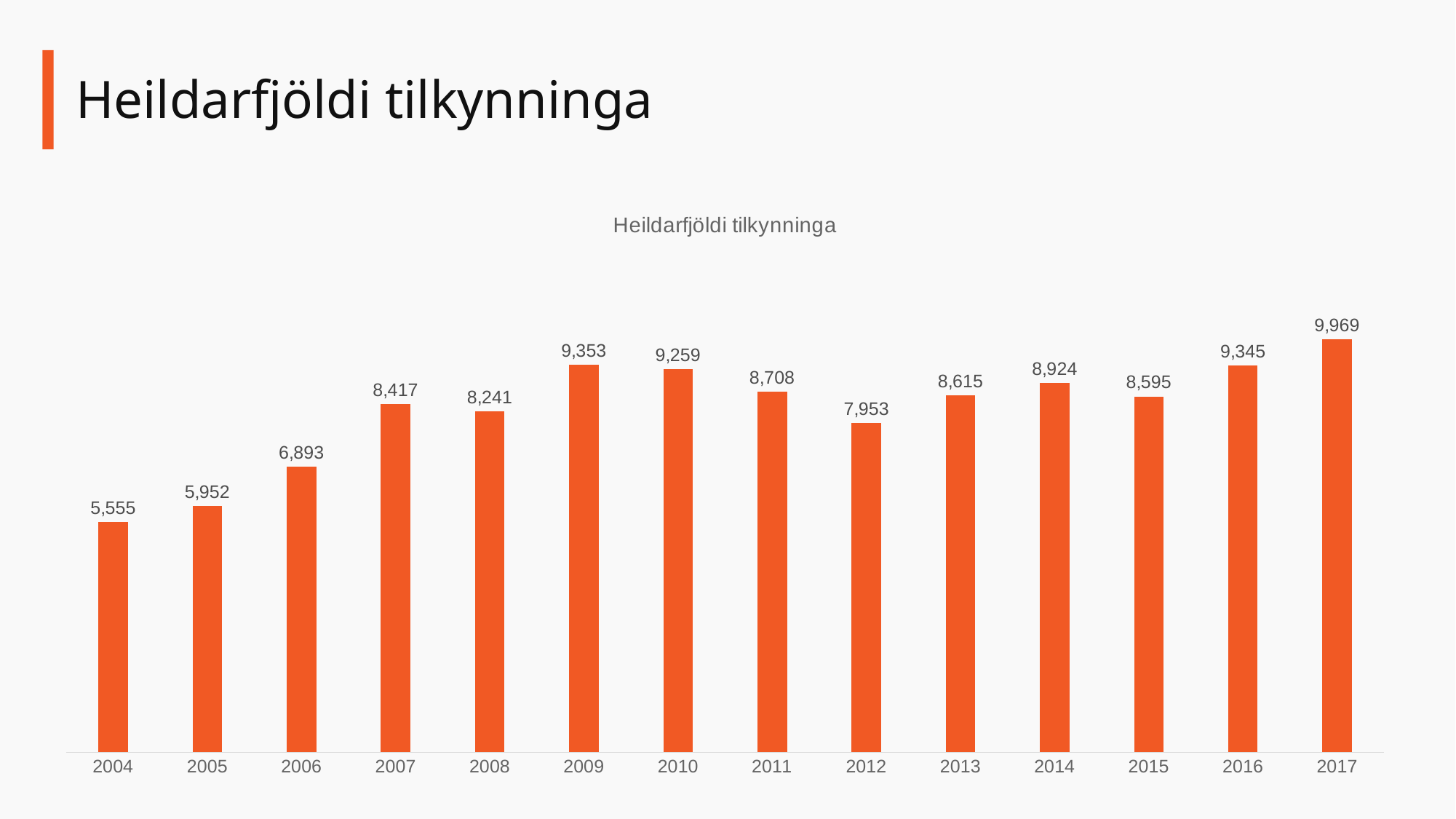
Do the values rise or fall from 2004 to 2007? rise What is the difference between the values for 2009 and 2008? 1,112 How many years are shown on the x axis? 14 Which year has the lowest value? 2004 What is the value for 2012? 7,953 Which year has the highest value? 2017 What is the title of the chart? Heildarfjöldi tilkynninga What is the value for 2017? 9,969 What is the difference between the values for 2017 and 2004? 4,414 Which is larger, the value for 2009 or the value for 2016? 2009 What kind of chart is this? bar chart What is the value for 2004? 5,555